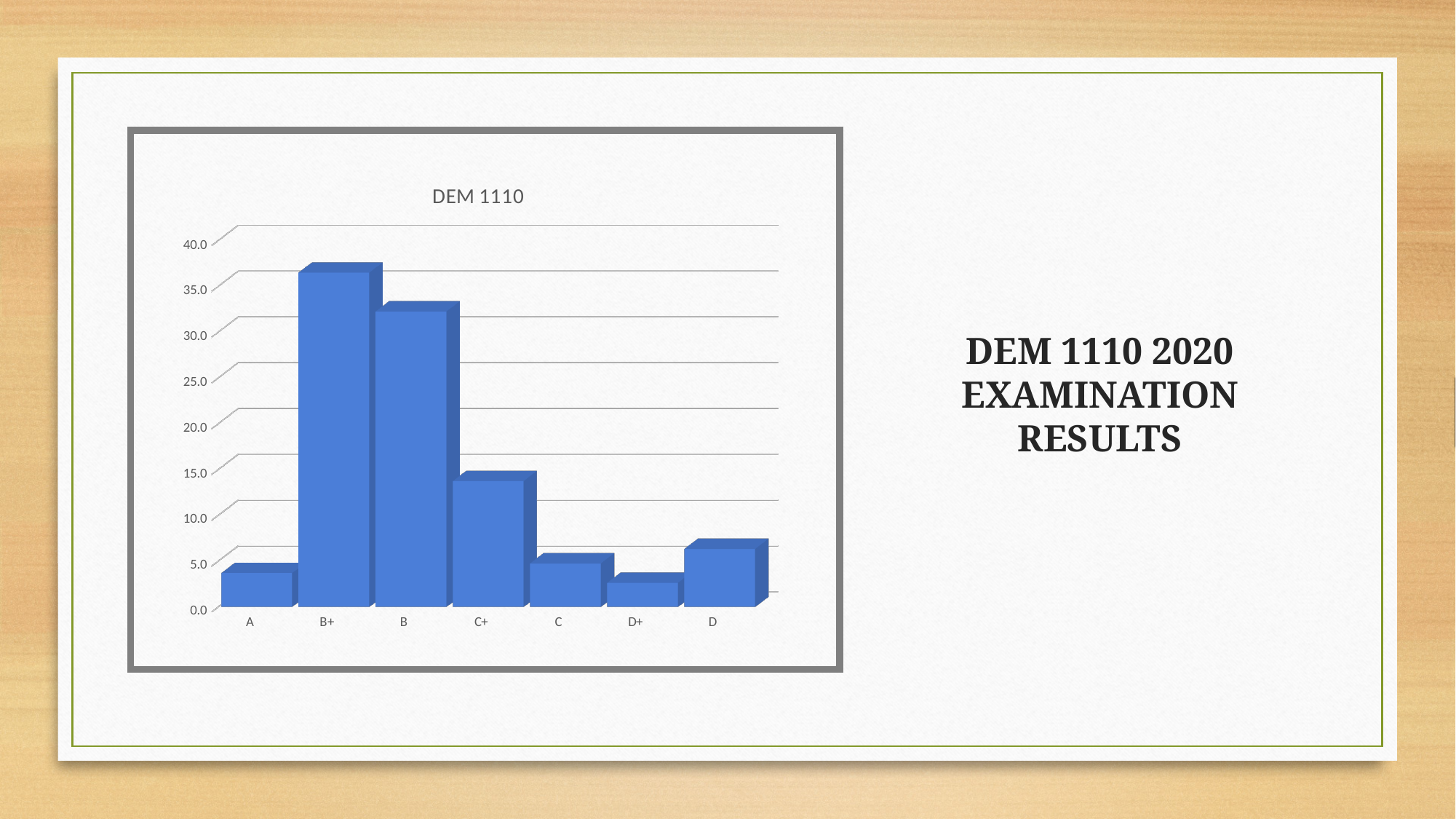
What kind of chart is shown on the slide? bar chart Is the value for D greater or less than 10? less Which is larger, the value for C+ or the value for C? C+ Is the value for B+ greater or less than 30? greater Which grade category has the highest bar in the chart? B+ Is the value for A greater or less than 10? less Which is larger, the value for B+ or the value for B? B+ What is the title of the chart? DEM 1110 How many grade categories are shown on the x axis of the chart? 7